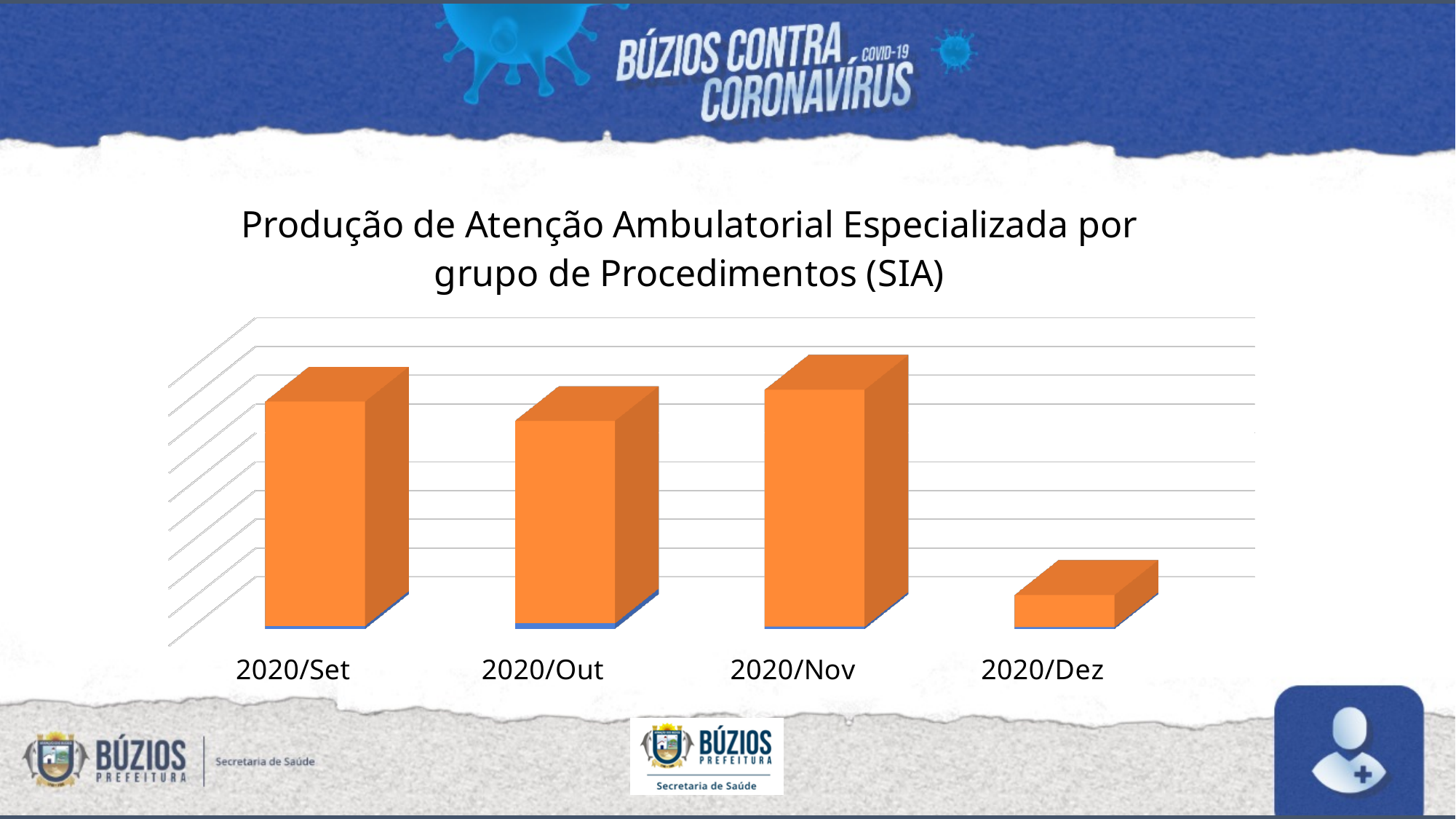
Which month has the highest bar on the chart? 2020/Nov Does the value rise or fall from 2020/Nov to 2020/Dez? Fall How many categories (months) are plotted on the chart? 4 What is the title of the chart? Produção de Atenção Ambulatorial Especializada por grupo de Procedimentos (SIA) Does the value rise or fall from 2020/Out to 2020/Nov? Rise What kind of chart is shown on the slide? Bar chart Which is larger, the value for 2020/Set or the value for 2020/Out? 2020/Set Which month has the lowest bar on the chart? 2020/Dez Which is larger, the value for 2020/Nov or the value for 2020/Dez? 2020/Nov Which is larger, the value for 2020/Out or the value for 2020/Nov? 2020/Nov What colour are the bars on the chart? Orange